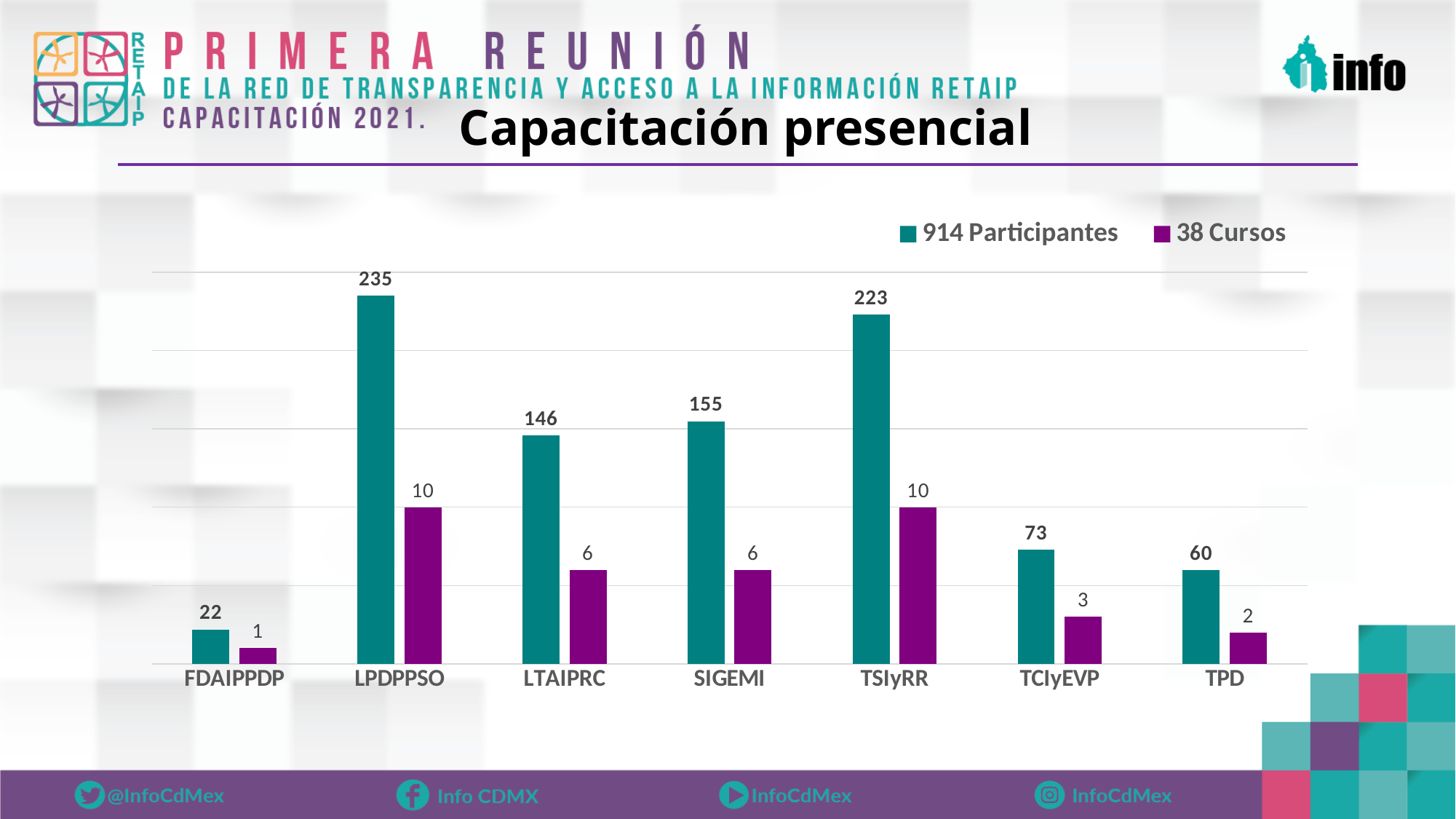
What kind of chart is shown on the slide? Bar chart Which category has the highest number of participants? LPDPPSO What is the difference in courses between LTAIPRC and TPD? 4 How many participants are shown for TPD? 60 What is the difference in participants between LPDPPSO and TSIyRR? 12 Which has more participants, SIGEMI or LTAIPRC? SIGEMI How many participants (914 Participantes) are shown for LPDPPSO? 235 How many series does the legend list? 2 What is the title of the chart on the slide? Capacitación presencial Which category has the lowest number of courses? FDAIPPDP How many courses (38 Cursos) are shown for TCIyEVP? 3 How many categories are shown on the x axis? 7